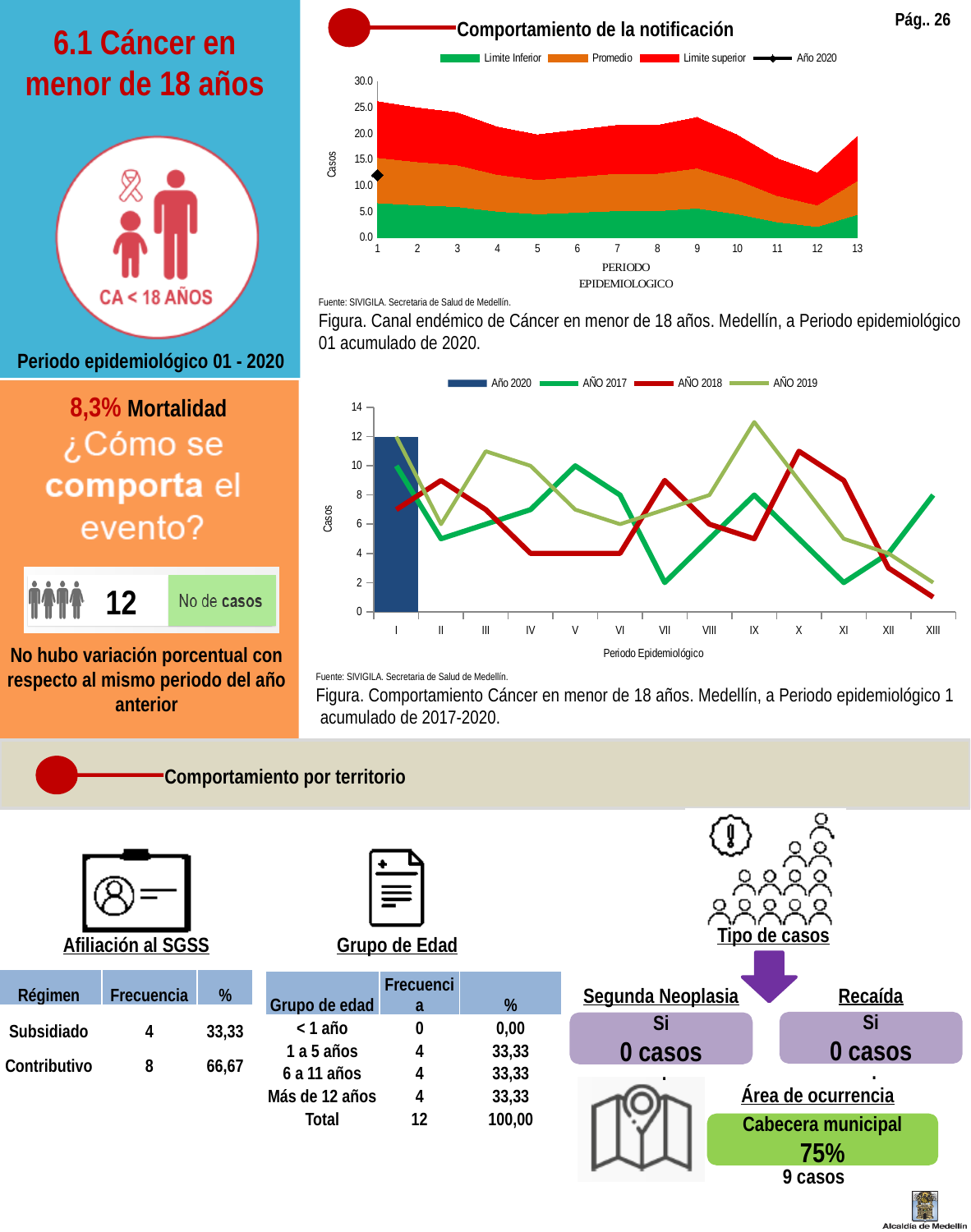
In the bottom chart (Comportamiento Cáncer en menor de 18 años, 2017-2020), is the AÑO 2018 value at period XIII greater or less than 2? less In the bottom chart (Comportamiento Cáncer en menor de 18 años, 2017-2020), is the AÑO 2017 value at period V greater or less than 8? greater In the bottom chart (Comportamiento Cáncer en menor de 18 años, 2017-2020), which series has the highest value at period IX? AÑO 2019 What kind of chart is the top chart (Comportamiento de la notificación)? area chart In the top chart (Comportamiento de la notificación), is the Limite superior value at period 1 greater or less than 20? greater In the bottom chart (Comportamiento Cáncer en menor de 18 años, 2017-2020), how many epidemiological periods are shown on the x axis? 13 In the bottom chart (Comportamiento Cáncer en menor de 18 años, 2017-2020), what is the value of the Año 2020 bar at period I? 12 In the top chart (Comportamiento de la notificación), how many series does the legend list? 4 In the bottom chart (Comportamiento Cáncer en menor de 18 años, 2017-2020), at period VII, which is larger: the AÑO 2017 value or the AÑO 2018 value? AÑO 2018 In the bottom chart (Comportamiento Cáncer en menor de 18 años, 2017-2020), how many series does the legend list? 4